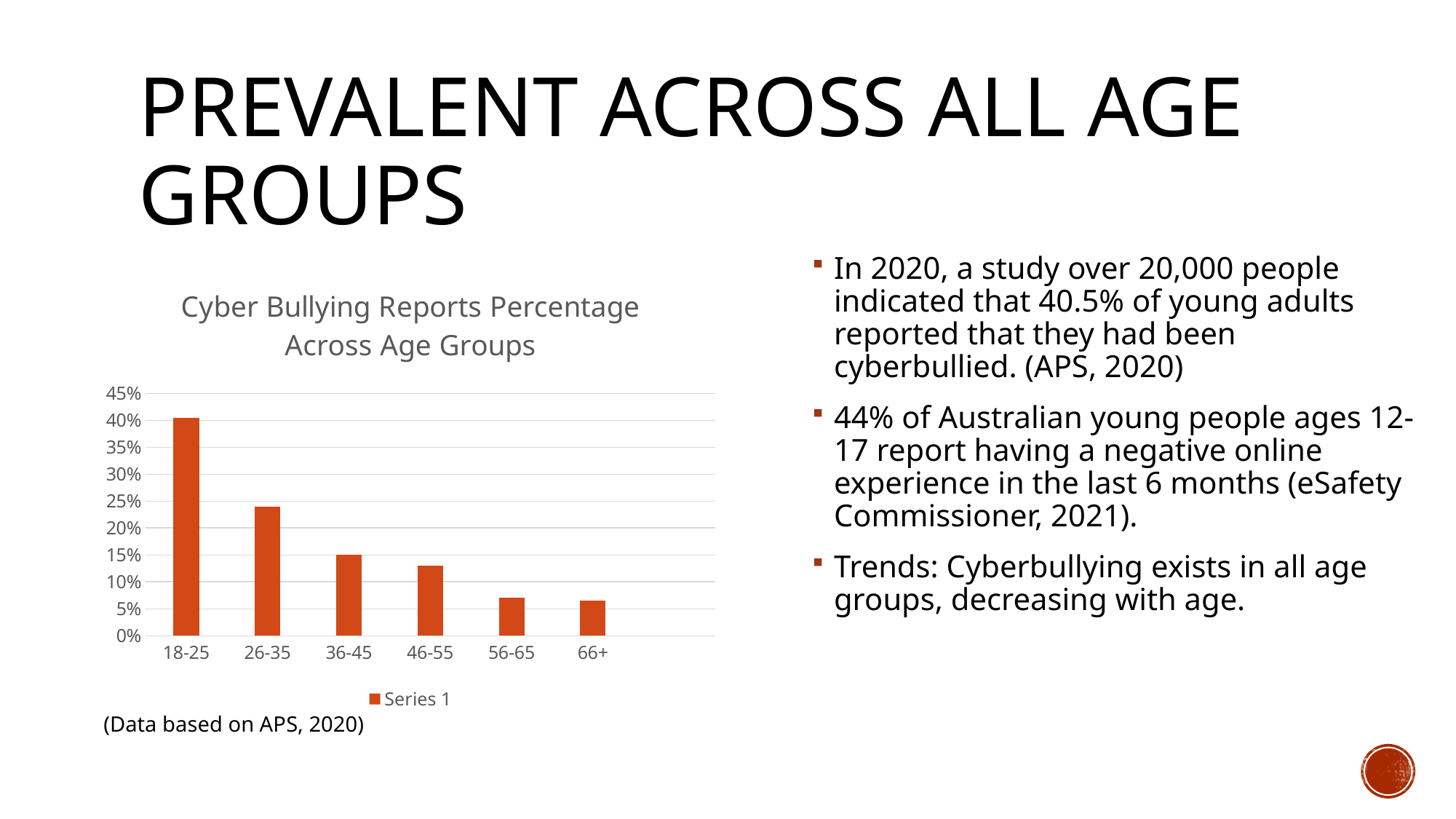
What kind of chart is shown on the slide? bar chart Is the value for 18-25 greater or less than 35%? greater Is the value for 46-55 greater or less than 15%? less How many age groups are shown on the x axis of the chart? 6 What is the name of the series shown in the chart's legend? Series 1 Do the values rise or fall as you move from 18-25 to 66+ along the x axis? fall Which age group has the highest cyber bullying reports percentage? 18-25 How many series does the chart's legend list? 1 Which is larger, the value for 26-35 or the value for 46-55? 26-35 Is the value for 26-35 greater or less than 20%? greater What is the title of the chart? Cyber Bullying Reports Percentage Across Age Groups